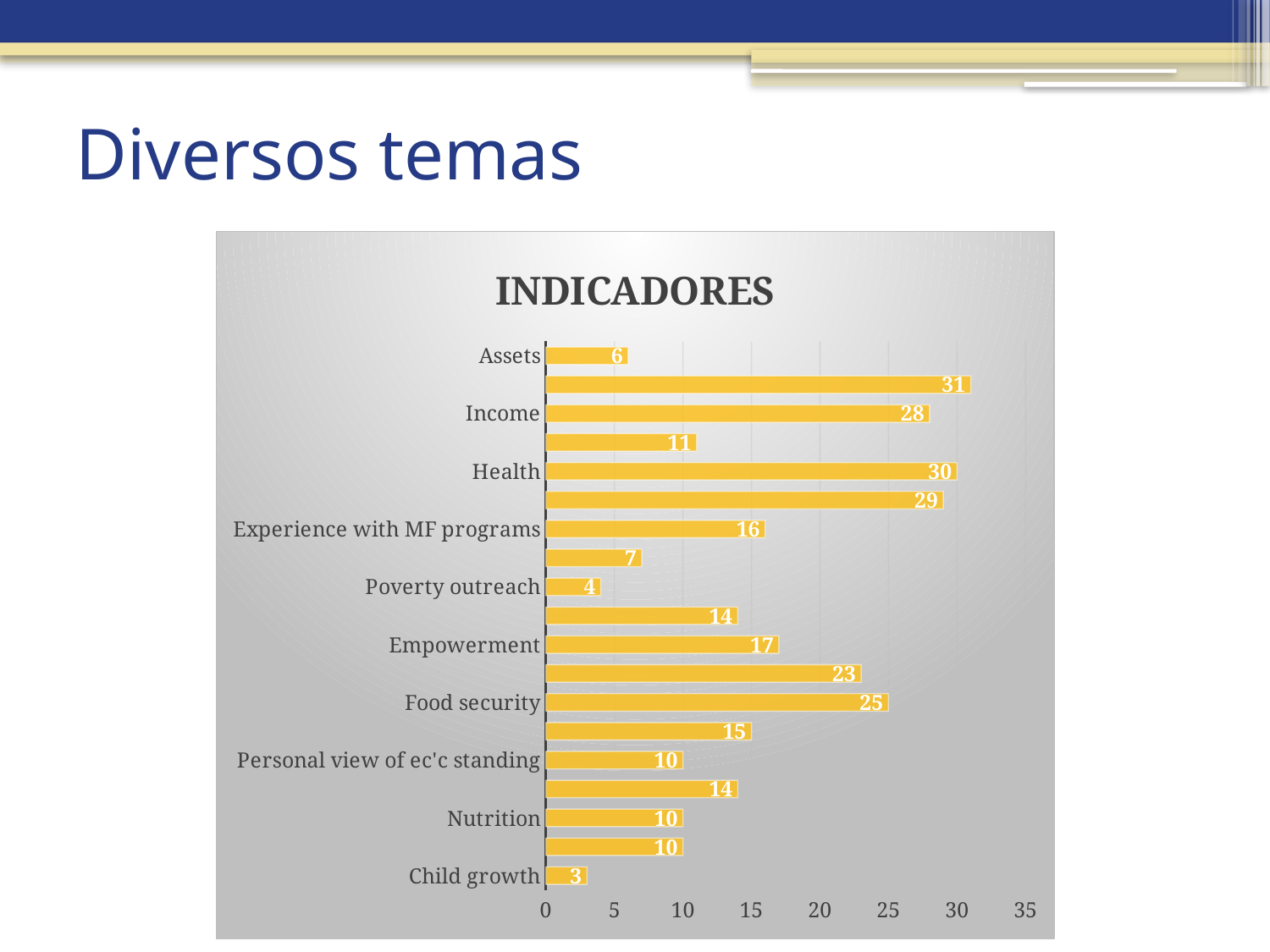
What is the title of the chart on the slide? INDICADORES What is the value for Income in the INDICADORES chart? 28 How many bars are plotted in the INDICADORES chart? 19 What kind of chart is shown on the slide? bar chart Is the value for Food security in the INDICADORES chart greater or less than 20? greater Which labeled category has the lowest value in the INDICADORES chart? Child growth What is the value for Child growth in the INDICADORES chart? 3 What is the value for Health in the INDICADORES chart? 30 What is the value for Poverty outreach in the INDICADORES chart? 4 What is the difference between the values for Health and Income in the INDICADORES chart? 2 What is the value for Food security in the INDICADORES chart? 25 Which has a larger value in the INDICADORES chart, Empowerment or Experience with MF programs? Empowerment